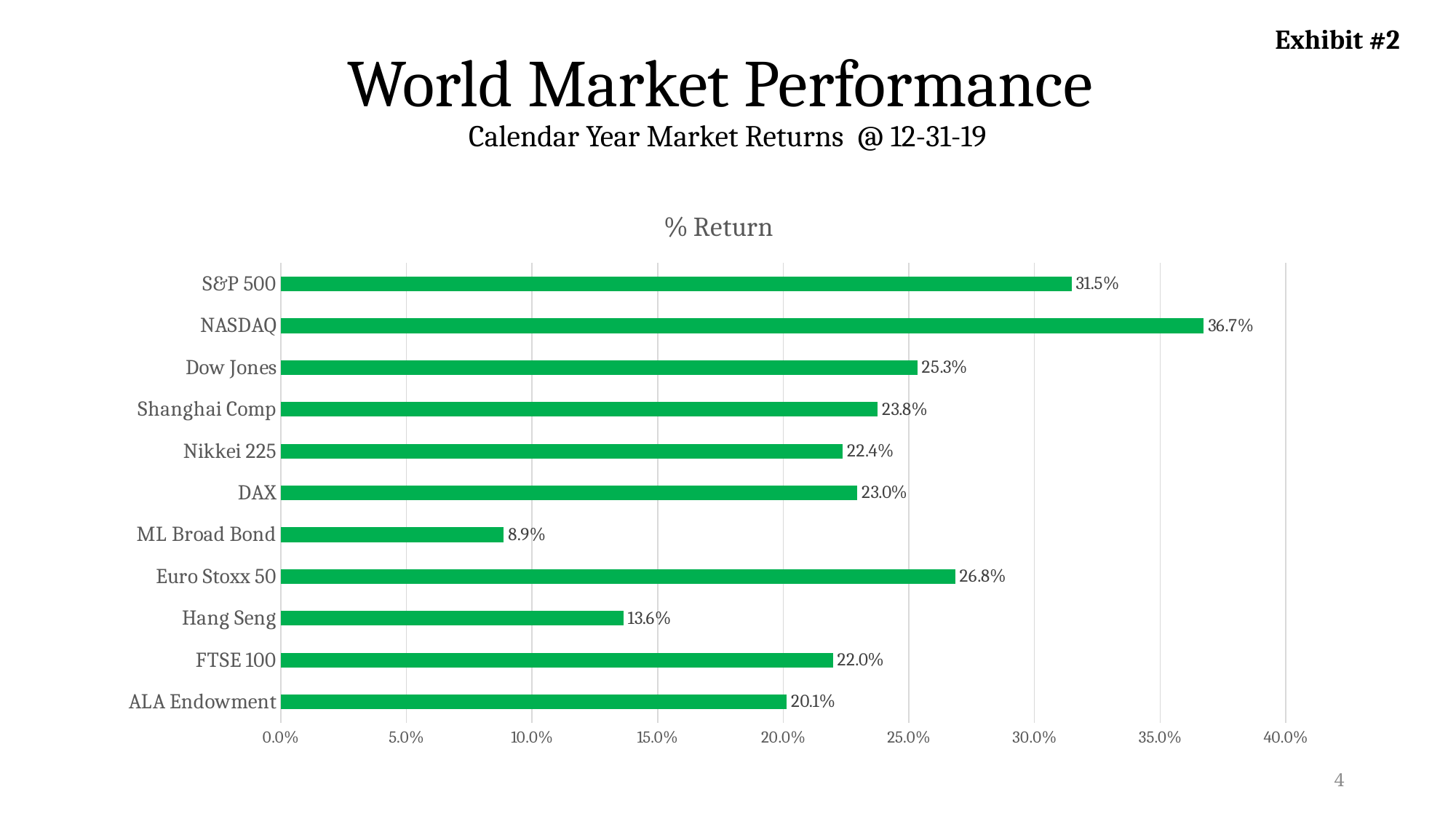
Is the value for Hang Seng greater or less than 15.0%? less Which category has the lowest % Return? ML Broad Bond How many categories are shown in the chart? 11 What is the % Return for NASDAQ? 36.7% Which has a higher % Return, Euro Stoxx 50 or Shanghai Comp? Euro Stoxx 50 Which index has the highest % Return? NASDAQ What is the difference between the FTSE 100 return and the Nikkei 225 return? 0.4% What is the % Return for ML Broad Bond? 8.9% What kind of chart is shown on the slide? bar chart What is the title of the chart? % Return What is the % Return for ALA Endowment? 20.1% What is the difference between the S&P 500 return and the Dow Jones return? 6.2%